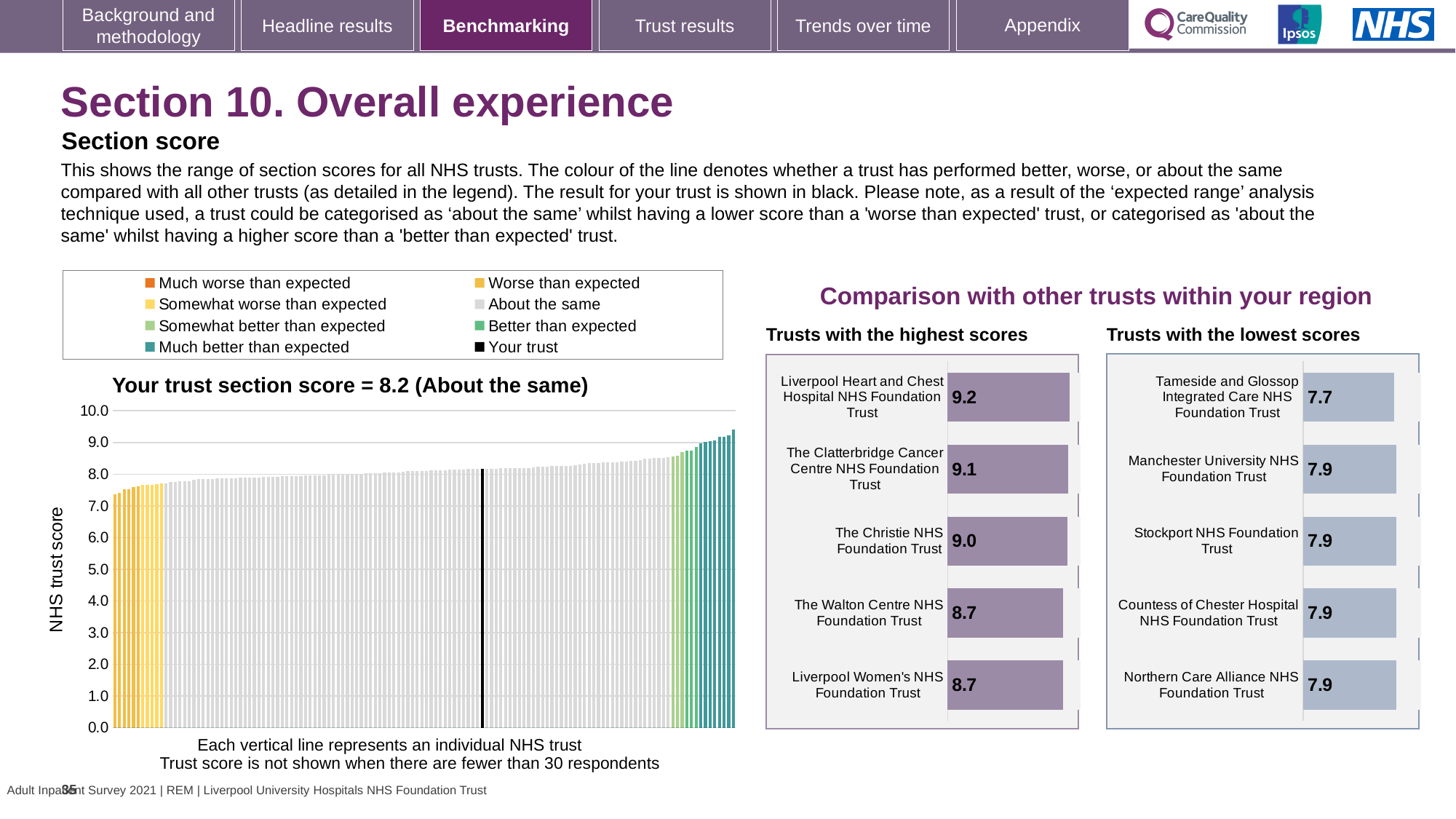
In the 'Your trust section score' chart, do the trust scores rise or fall from left to right along the x axis? rise In the 'Your trust section score' chart, what is the section score for your trust? 8.2 In the 'Trusts with the lowest scores' chart, which trust has the lowest score? Tameside and Glossop Integrated Care NHS Foundation Trust What kind of chart is the 'Your trust section score' chart? bar chart In the 'Trusts with the highest scores' chart, what is the difference between the scores of Liverpool Heart and Chest Hospital NHS Foundation Trust and The Walton Centre NHS Foundation Trust? 0.5 In the 'Trusts with the lowest scores' chart, what is the difference between the scores of Stockport NHS Foundation Trust and Tameside and Glossop Integrated Care NHS Foundation Trust? 0.2 In the 'Trusts with the highest scores' chart, which trust has the highest score? Liverpool Heart and Chest Hospital NHS Foundation Trust In the 'Trusts with the highest scores' chart, how many trusts are shown? 5 How many entries does the legend above the 'Your trust section score' chart list? 8 In the 'Trusts with the highest scores' chart, which has the larger score: The Christie NHS Foundation Trust or Liverpool Women's NHS Foundation Trust? The Christie NHS Foundation Trust In the 'Trusts with the highest scores' chart, what is the score for The Christie NHS Foundation Trust? 9.0 In the 'Trusts with the lowest scores' chart, what is the score for Tameside and Glossop Integrated Care NHS Foundation Trust? 7.7